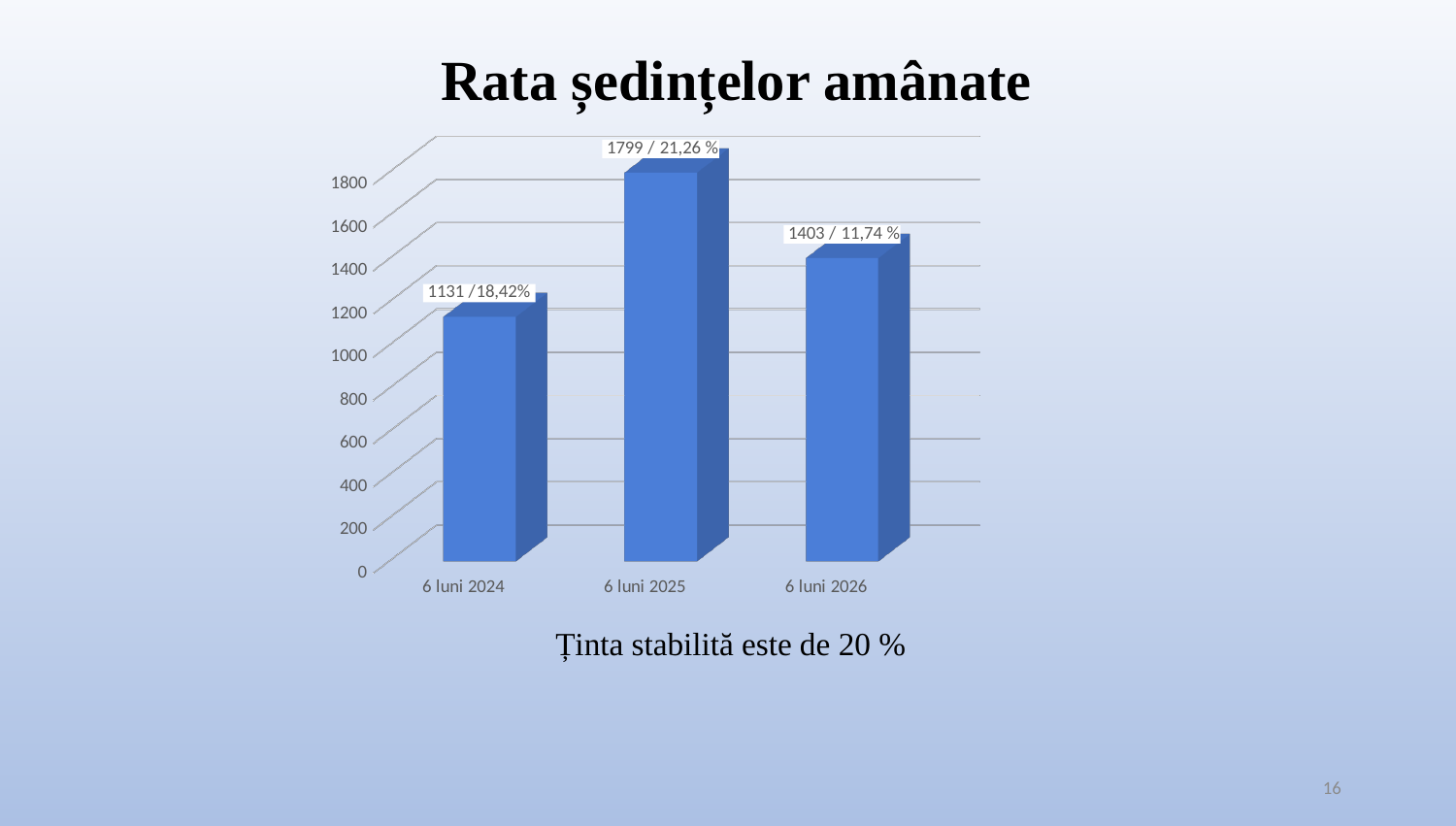
Which category has the lowest bar? 6 luni 2024 What kind of chart is shown on the slide? bar chart What is the difference between the count for 6 luni 2025 and the count for 6 luni 2026? 396 What is the data label shown for 6 luni 2025? 1799 / 21,26 % What is the difference between the count for 6 luni 2025 and the count for 6 luni 2024? 668 How many categories are shown on the x axis? 3 Which category has the highest bar? 6 luni 2025 Is the value for 6 luni 2026 greater or less than 1200? greater What is the data label shown for 6 luni 2026? 1403 / 11,74 % What is the title of the chart? Rata ședințelor amânate Which is larger, the value for 6 luni 2026 or the value for 6 luni 2024? 6 luni 2026 What is the data label shown for 6 luni 2024? 1131 /18,42%